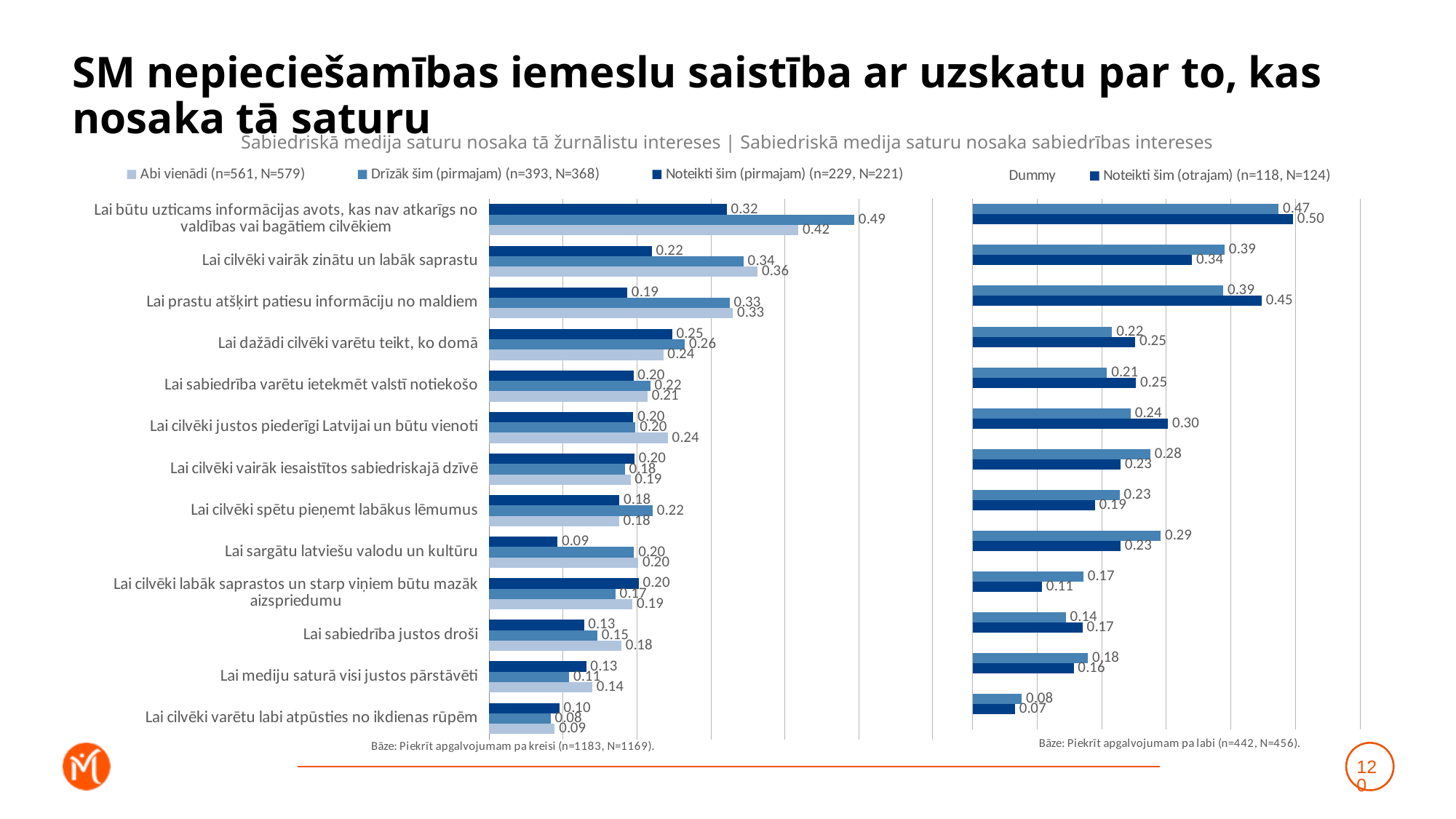
In the left chart, which category has the highest value for the 'Drīzāk šim (pirmajam)' series? Lai būtu uzticams informācijas avots, kas nav atkarīgs no valdības vai bagātiem cilvēkiem In the left chart, what is the value of the 'Noteikti šim (pirmajam)' series for 'Lai sargātu latviešu valodu un kultūru'? 0.09 How many series does the legend of the left chart list? 3 In the left chart, what is the difference between the 'Drīzāk šim (pirmajam)' and 'Noteikti šim (pirmajam)' values for 'Lai būtu uzticams informācijas avots, kas nav atkarīgs no valdības vai bagātiem cilvēkiem'? 0.17 How many categories are shown in the left chart? 13 In the right chart, what is the value of the 'Noteikti šim (otrajam)' series for 'Lai prastu atšķirt patiesu informāciju no maldiem'? 0.45 In the left chart, what is the value of the 'Abi vienādi' series for 'Lai būtu uzticams informācijas avots, kas nav atkarīgs no valdības vai bagātiem cilvēkiem'? 0.42 In the right chart, which category has the lowest value for the 'Noteikti šim (otrajam)' series? Lai cilvēki varētu labi atpūsties no ikdienas rūpēm In the left chart, which category has the lowest value for the 'Noteikti šim (pirmajam)' series? Lai sargātu latviešu valodu un kultūru In the right chart, what is the value of the 'Noteikti šim (otrajam)' series for 'Lai sabiedrība justos droši'? 0.17 In the left chart, what is the value of the 'Drīzāk šim (pirmajam)' series for 'Lai cilvēki spētu pieņemt labākus lēmumus'? 0.22 In the right chart, for the 'Noteikti šim (otrajam)' series, which is larger: 'Lai cilvēki justos piederīgi Latvijai un būtu vienoti' or 'Lai cilvēki vairāk iesaistītos sabiedriskajā dzīvē'? Lai cilvēki justos piederīgi Latvijai un būtu vienoti